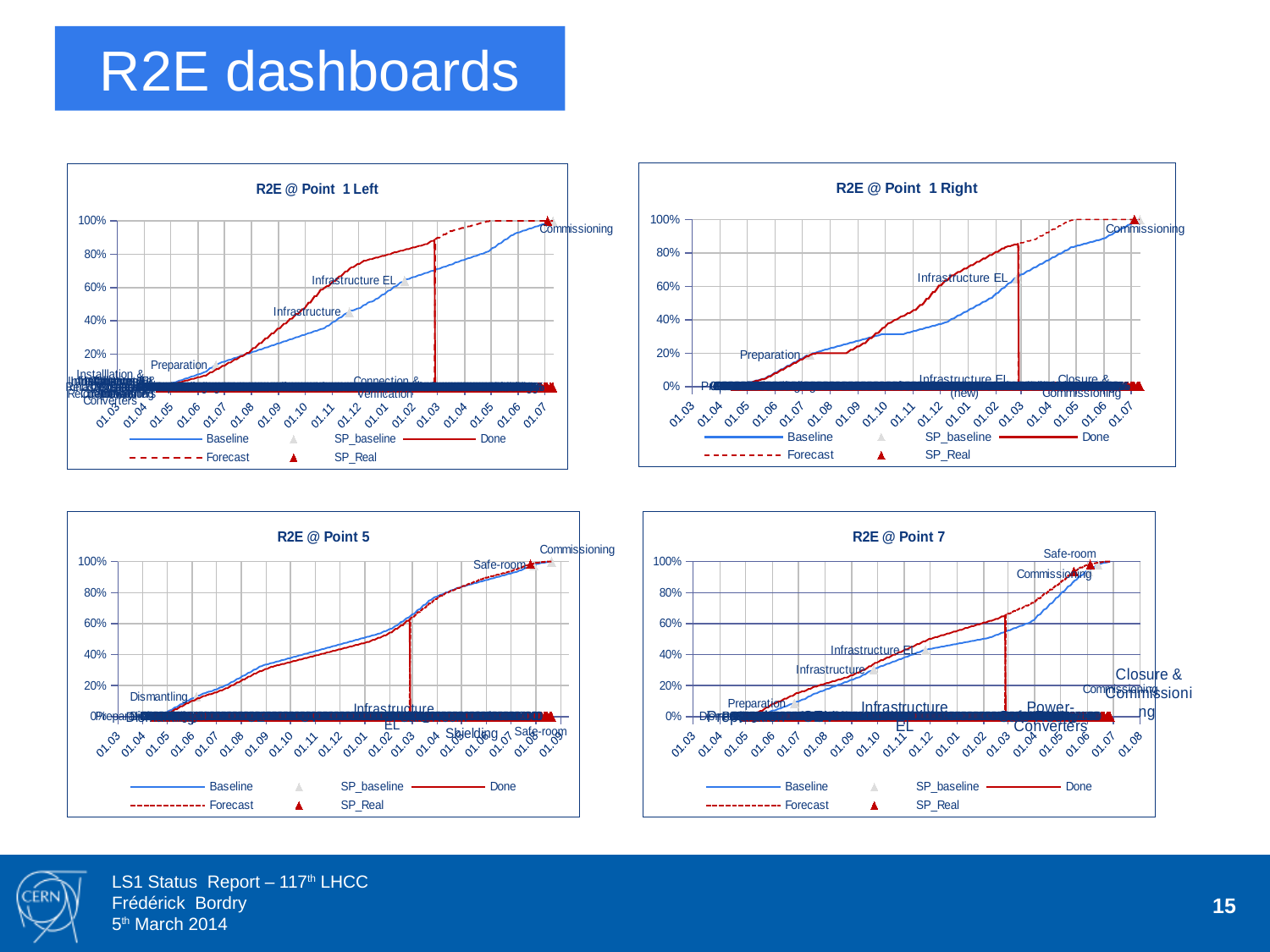
In "R2E @ Point 1 Right", is the value of the Done line just before its vertical drop at 01.03 greater or less than 80%? greater In "R2E @ Point 7", does the Baseline line rise or fall along the x axis? Rise In "R2E @ Point 5", is the Baseline value at 01.07 of the first year greater or less than 40%? less What is the title of the chart in the bottom-left position of the slide? R2E @ Point 5 How many charts are shown on the slide? 4 In "R2E @ Point 1 Left", does the Done line rise or fall between 01.04 and 01.02? Rise What kind of chart is "R2E @ Point 1 Left"? Line chart In "R2E @ Point 1 Left", is the value of the Done line just before its vertical drop at 01.03 greater or less than 80%? greater How many series does the legend of "R2E @ Point 5" list? 5 What is the highest value shown on the y axis of "R2E @ Point 1 Right"? 100% In the legend of "R2E @ Point 7", which series is drawn as a dashed line? Forecast